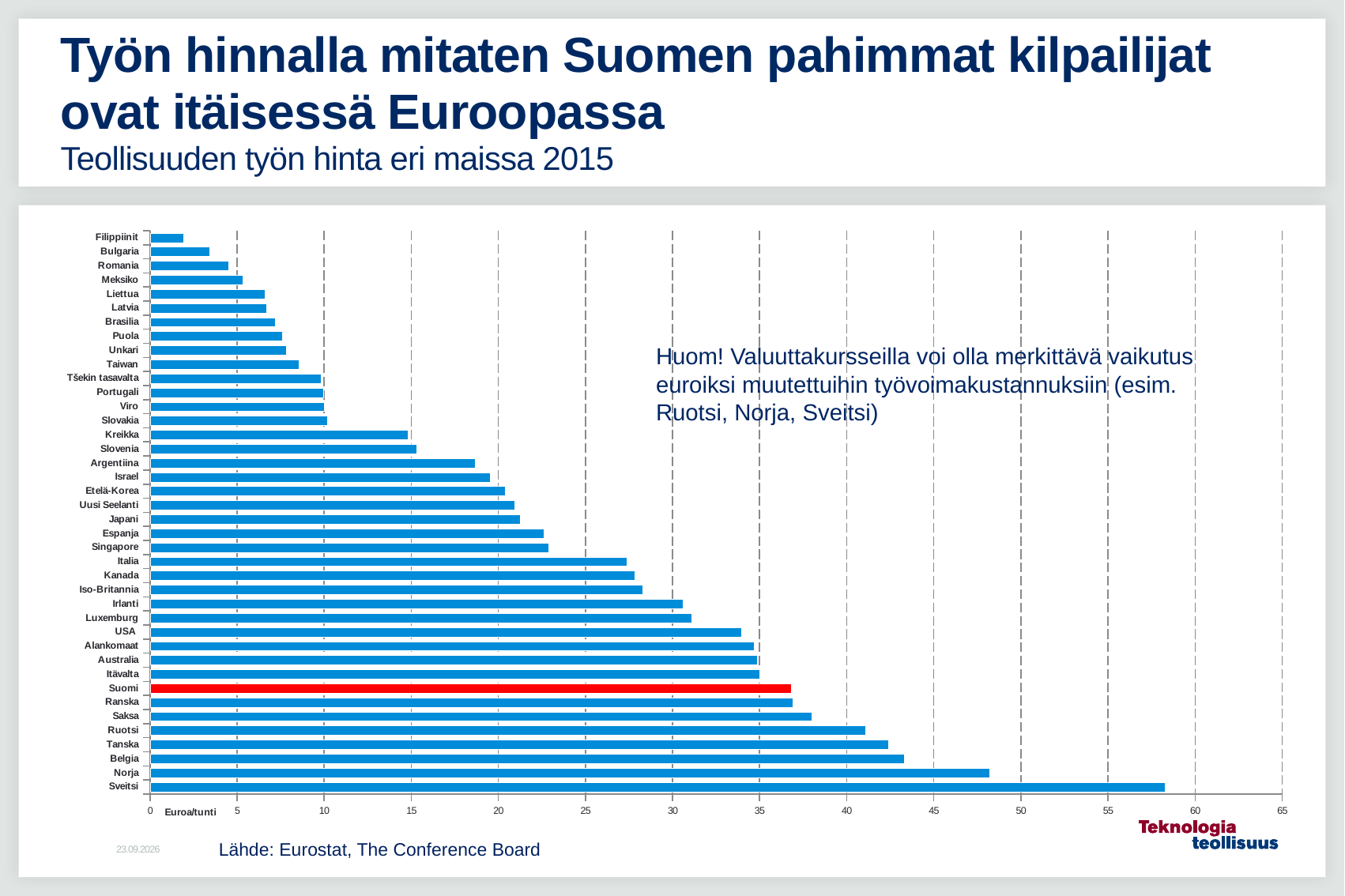
Is the value for Suomi greater or less than 35? greater Is the value for Norja greater or less than 45? greater Is the value for Sveitsi greater or less than 55? greater Which country has the highest industrial labour cost in the chart? Sveitsi Which country's bar is highlighted in red in the chart? Suomi Which has a higher value, Norja or Belgia? Norja How many countries are listed in the chart? 40 Which country has the lowest industrial labour cost in the chart? Filippiinit What kind of chart is shown on the slide? bar chart Which has a higher value, Suomi or Ruotsi? Ruotsi